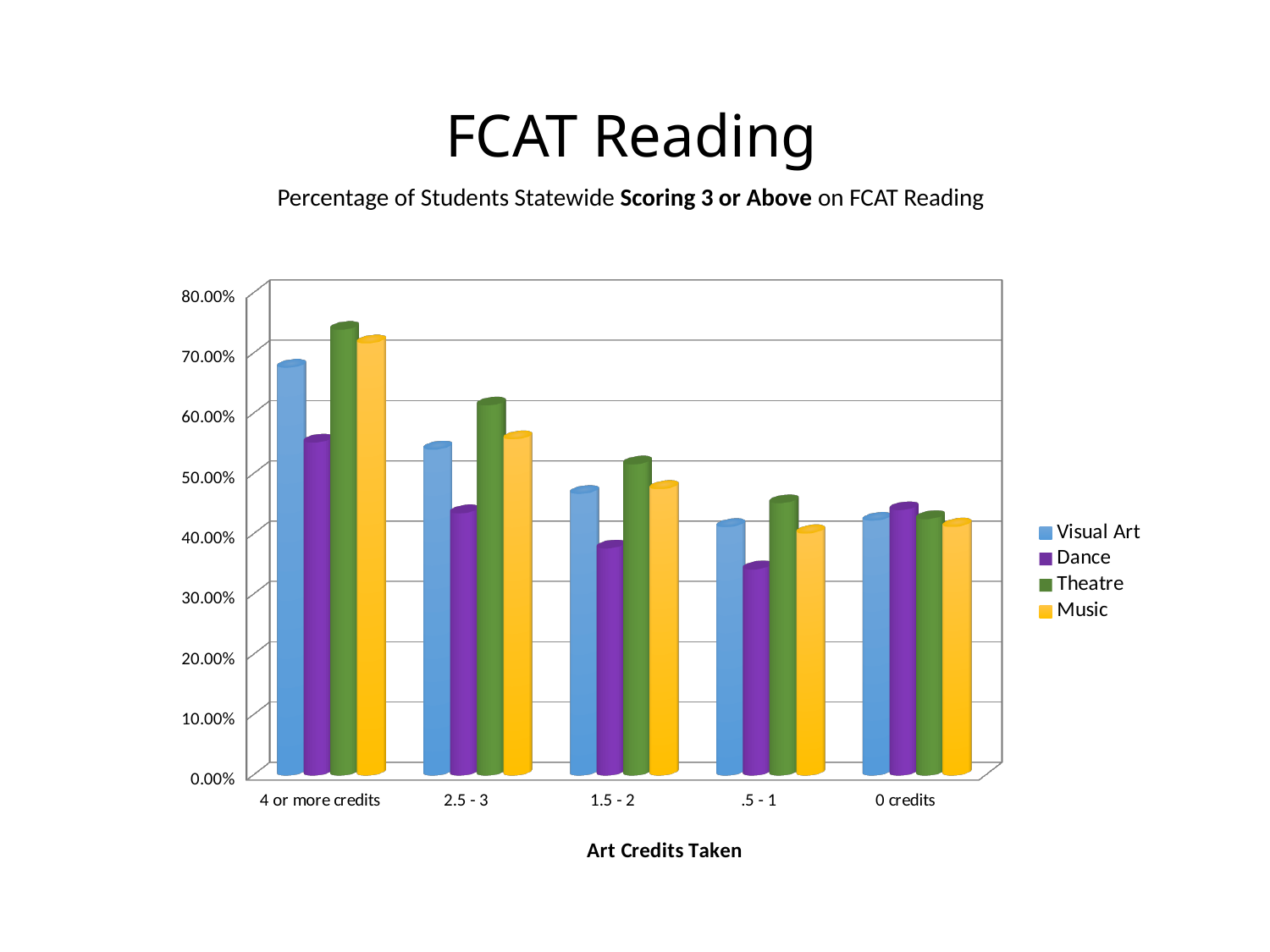
Do the Theatre values rise or fall from 4 or more credits to 0 credits? fall Which is larger at 2.5 - 3: Theatre or Dance? Theatre Is the value for Dance at .5 - 1 greater or less than 40.00%? less For which category is the Dance bar lowest? .5 - 1 How many series does the legend list? 4 Which series has the highest bar at 1.5 - 2? Theatre For which category is the Theatre bar highest? 4 or more credits Is the value for Theatre at 4 or more credits greater or less than 70.00%? greater What kind of chart is shown on the slide? bar chart Is the value for Visual Art at 4 or more credits greater or less than 60.00%? greater How many categories are shown on the x axis? 5 What is the title of the x axis? Art Credits Taken